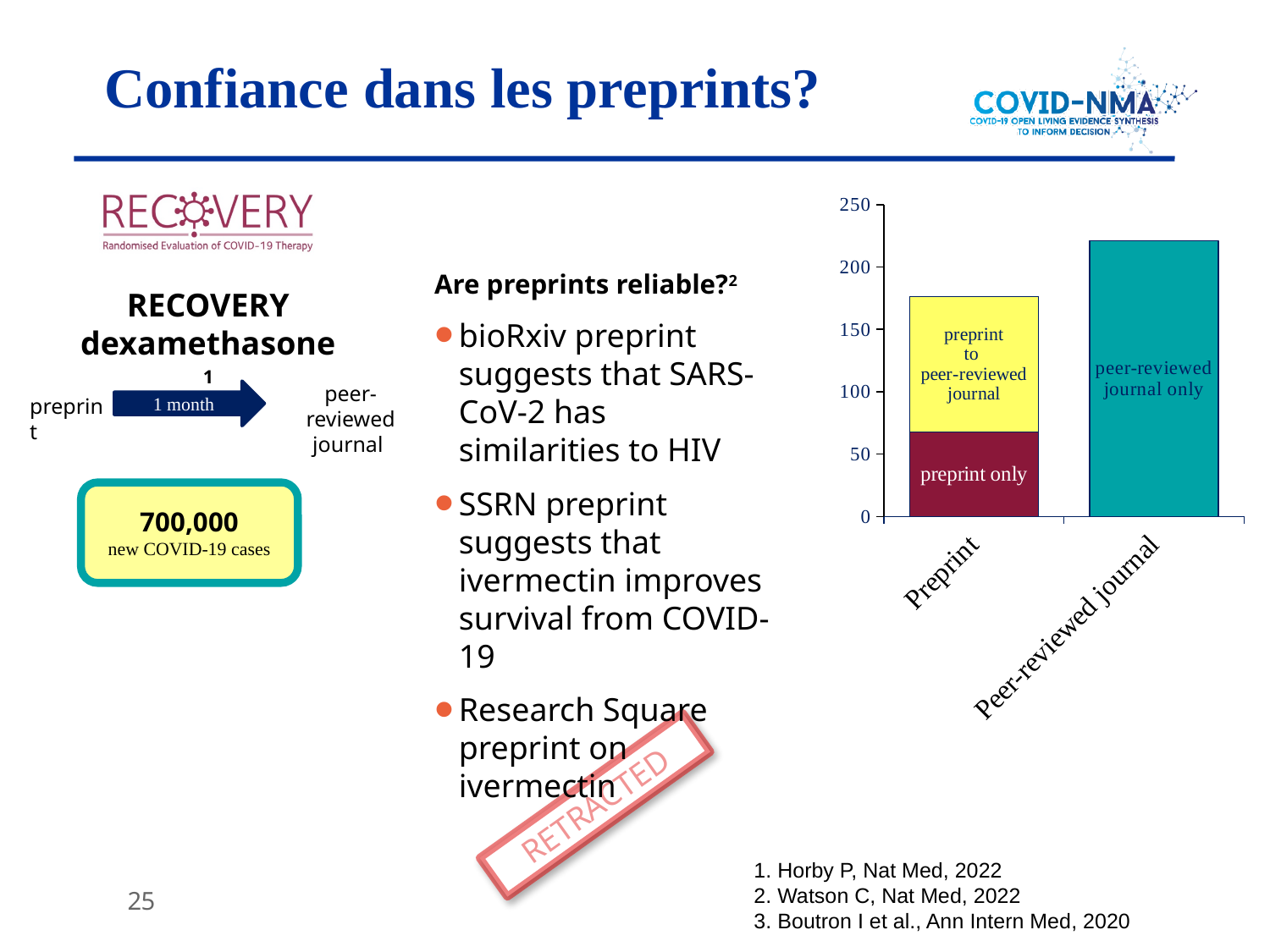
Is the total height of the Preprint bar greater or less than 200? less Which category has the taller bar in the chart, Preprint or Peer-reviewed journal? Peer-reviewed journal What is the highest value shown on the y axis of the chart? 250 Is the total height of the Preprint bar greater or less than 150? greater How many categories are shown on the x axis of the bar chart? 2 Is the 'preprint only' segment of the Preprint bar greater or less than 50? greater What kind of chart is shown on the right of the slide? bar chart What label is written inside the bar for Peer-reviewed journal? peer-reviewed journal only How many segments make up the Preprint bar? 2 Which is larger: the 'preprint only' segment or the 'preprint to peer-reviewed journal' segment of the Preprint bar? preprint to peer-reviewed journal